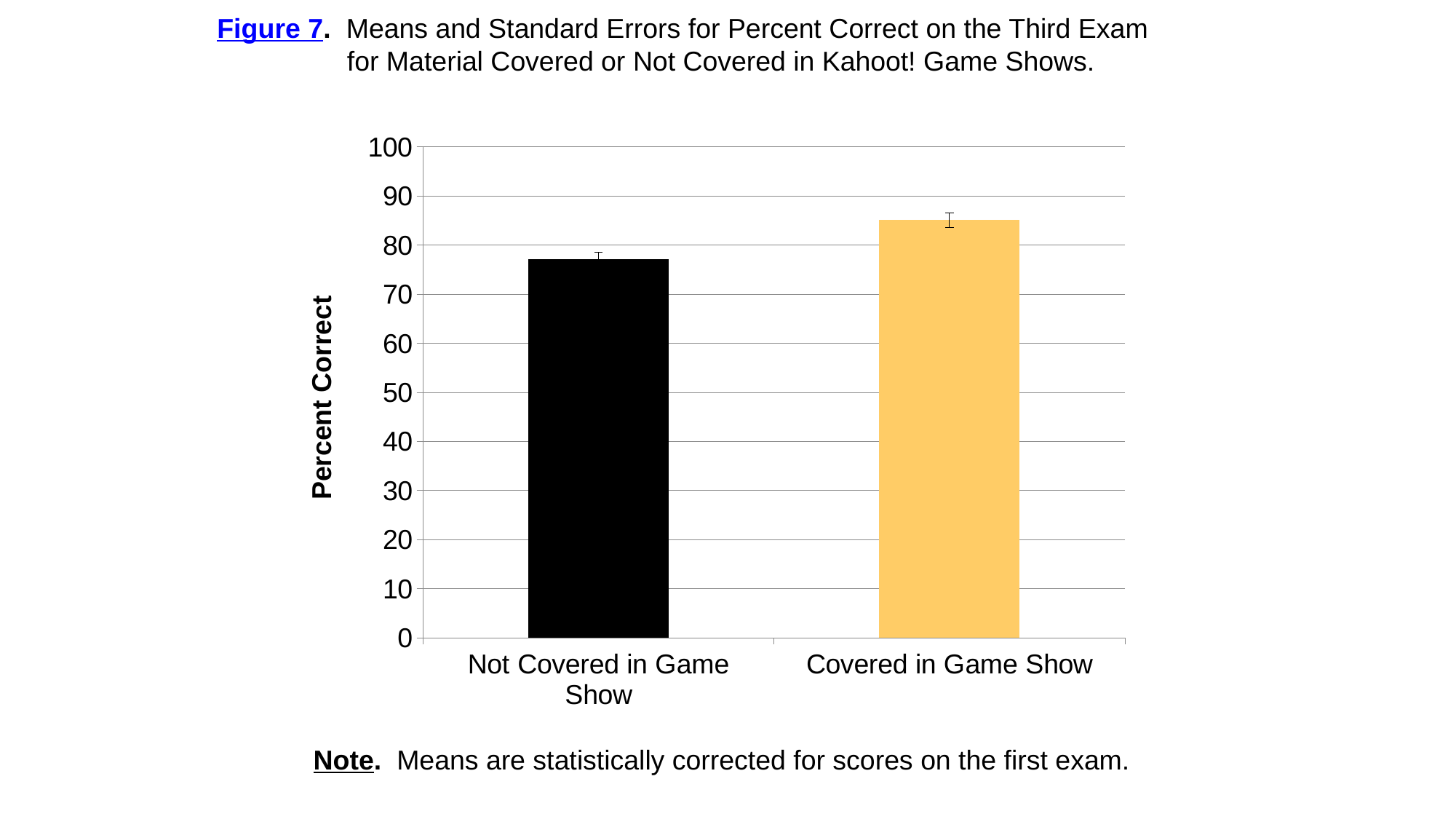
What is the maximum value shown on the y axis? 100 Which category has the higher percent correct? Covered in Game Show Is the value for Not Covered in Game Show greater or less than 70? greater Is the value for Not Covered in Game Show greater or less than 80? less What colour is the bar for Covered in Game Show? yellow Which category has the lower percent correct? Not Covered in Game Show Is the value for Covered in Game Show greater or less than 90? less What kind of chart is shown on the slide? bar chart Which is larger: the value for Covered in Game Show or the value for Not Covered in Game Show? Covered in Game Show What is the label on the y axis? Percent Correct How many categories are plotted on the x axis? 2